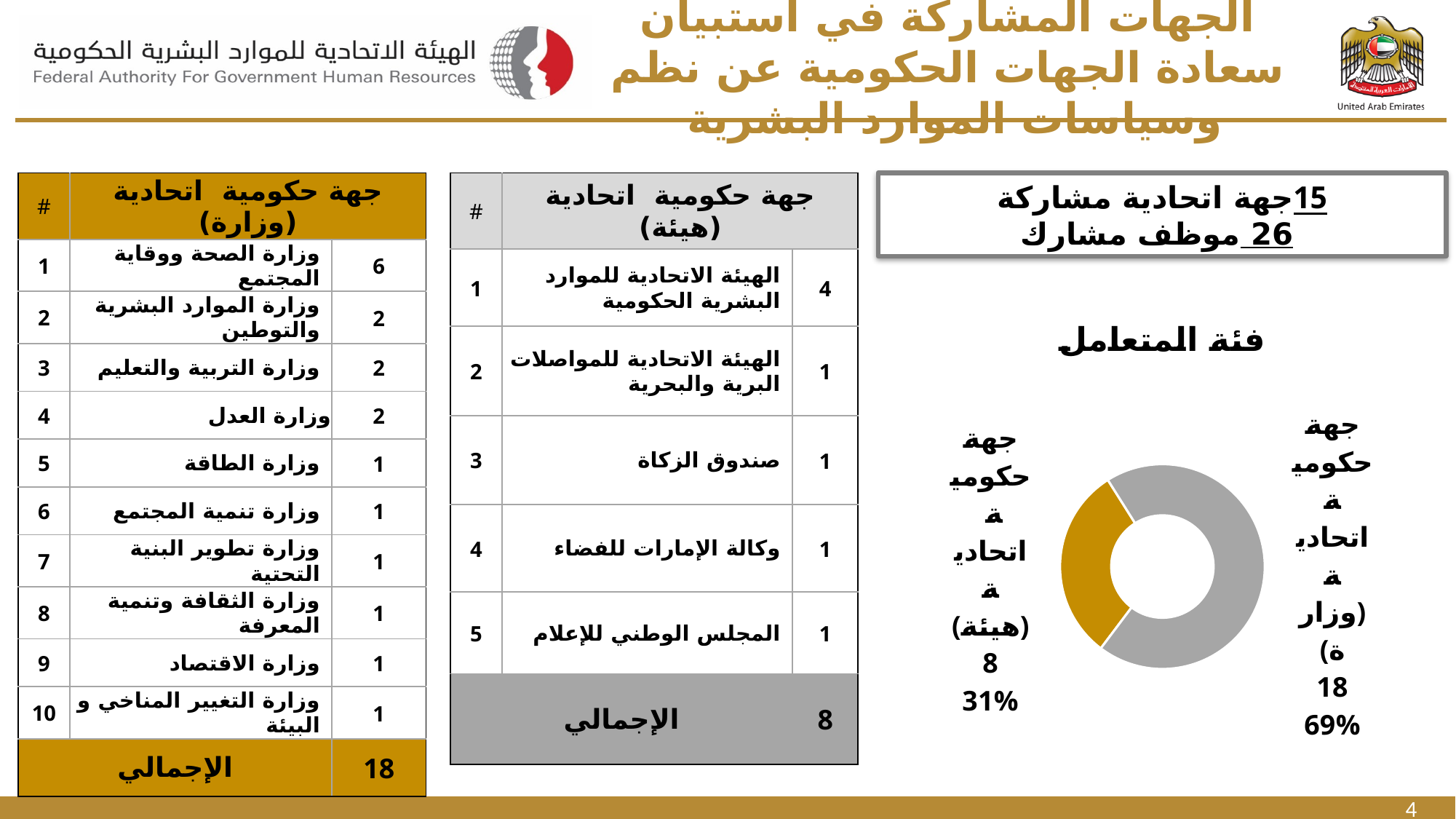
What is the total of the two values shown in the "فئة المتعامل" chart? 26 In the "فئة المتعامل" chart, which category has the largest slice? جهة حكومية اتحادية (وزارة) In the "فئة المتعامل" chart, what value is shown for "جهة حكومية اتحادية (هيئة)"? 8 In the "فئة المتعامل" chart, what colour is the slice for "جهة حكومية اتحادية (هيئة)"? Gold What kind of chart is shown under the heading "فئة المتعامل"? Doughnut (pie) chart In the "فئة المتعامل" chart, which category has the smallest slice? جهة حكومية اتحادية (هيئة) How many categories (slices) does the "فئة المتعامل" chart show? 2 In the "فئة المتعامل" chart, what percentage share does "جهة حكومية اتحادية (هيئة)" have? 31% In the "فئة المتعامل" chart, which is larger: the value for "جهة حكومية اتحادية (وزارة)" or for "جهة حكومية اتحادية (هيئة)"? جهة حكومية اتحادية (وزارة) In the "فئة المتعامل" chart, what percentage share does "جهة حكومية اتحادية (وزارة)" have? 69% In the "فئة المتعامل" chart, what is the difference between the values for "جهة حكومية اتحادية (وزارة)" and "جهة حكومية اتحادية (هيئة)"? 10 In the "فئة المتعامل" chart, what value is shown for "جهة حكومية اتحادية (وزارة)"? 18